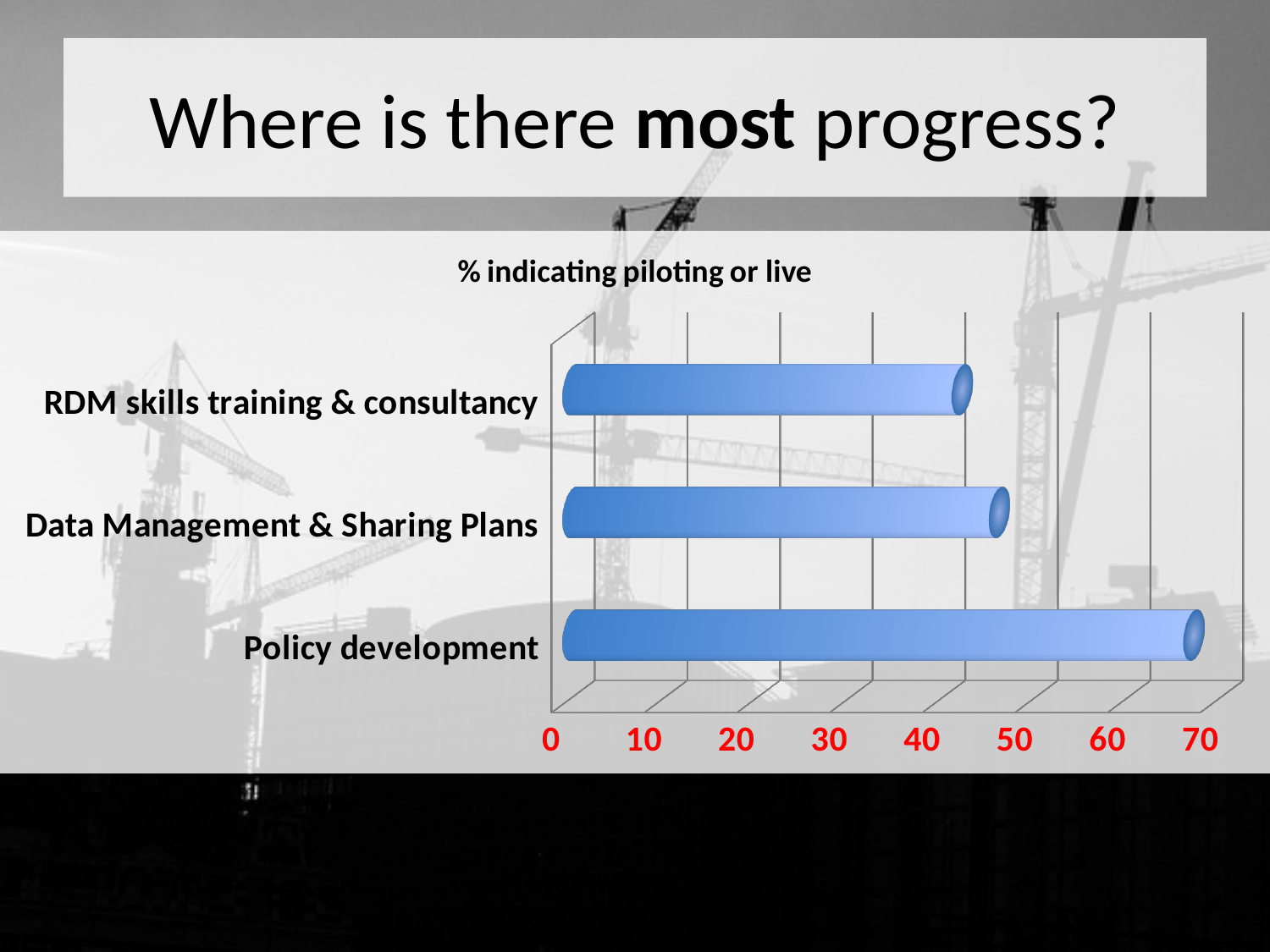
Is the value for RDM skills training & consultancy greater or less than 50? less Which is larger, the value for Policy development or the value for Data Management & Sharing Plans? Policy development What is the title of the chart? % indicating piloting or live What is the highest value shown on the horizontal axis of the chart? 70 Is the value for Policy development greater or less than 60? greater How many categories are plotted in the chart? 3 Which category has the highest value in the chart? Policy development Is the value for Data Management & Sharing Plans greater or less than 40? greater Which category has the lowest value in the chart? RDM skills training & consultancy What kind of chart is shown on the slide? bar chart Which is larger, the value for Data Management & Sharing Plans or the value for RDM skills training & consultancy? Data Management & Sharing Plans